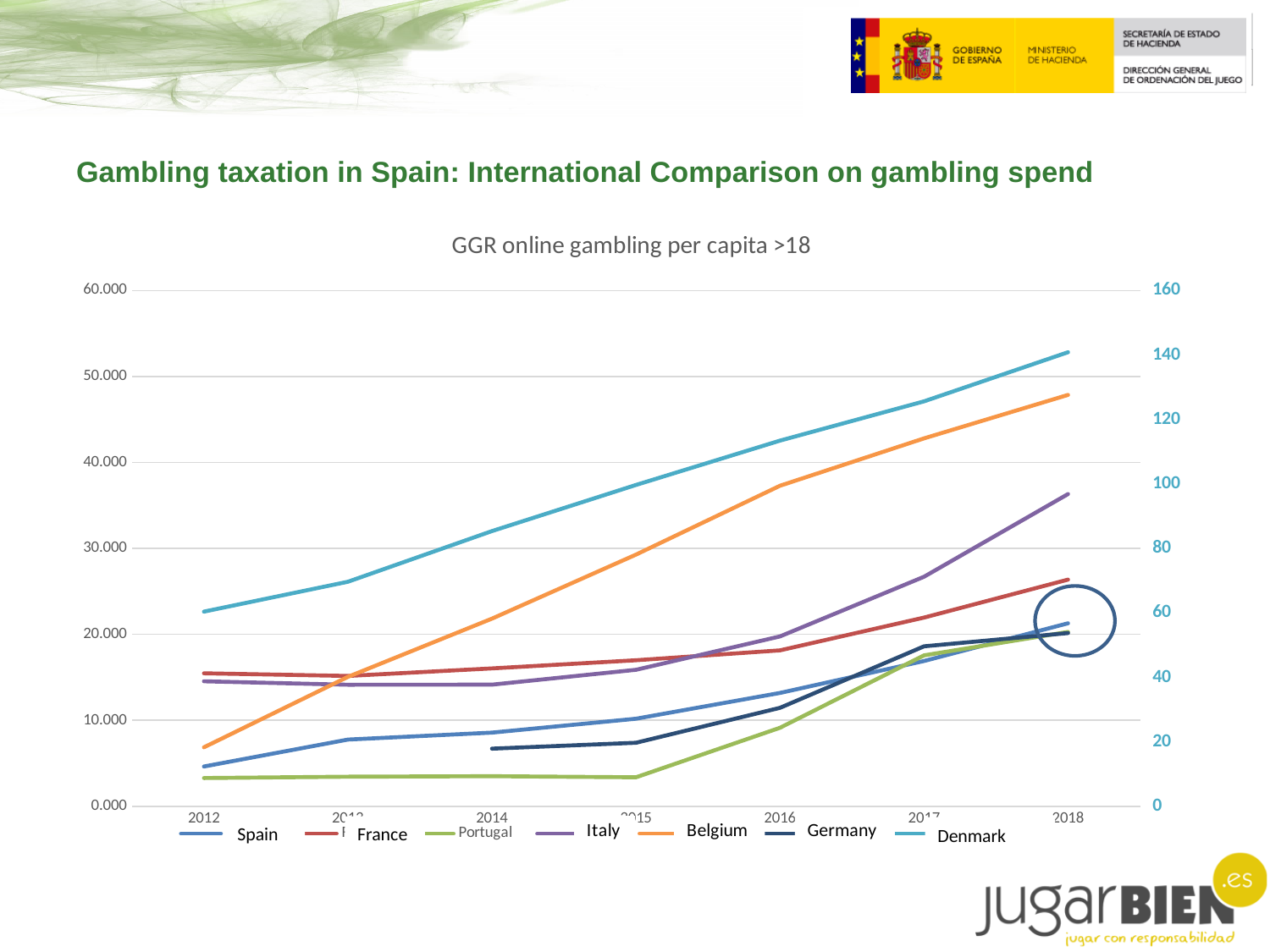
Does the line for Belgium rise or fall from 2012 to 2018? rises Which country has the highest GGR online gambling per capita in 2018? Denmark Which country has the lowest GGR online gambling per capita in 2012? Portugal In 2018, which is higher: Belgium or Italy? Belgium How many years are shown along the x axis of the chart? 7 Which country's line only begins in 2014 rather than 2012? Germany What is the title of the chart? GGR online gambling per capita >18 Which country has the highest GGR online gambling per capita in 2012? Denmark What kind of chart is shown on the slide? line chart In 2012, which is higher: France or Spain? France Does the line for Denmark rise or fall from 2012 to 2018? rises How many series does the legend of the chart list? 7